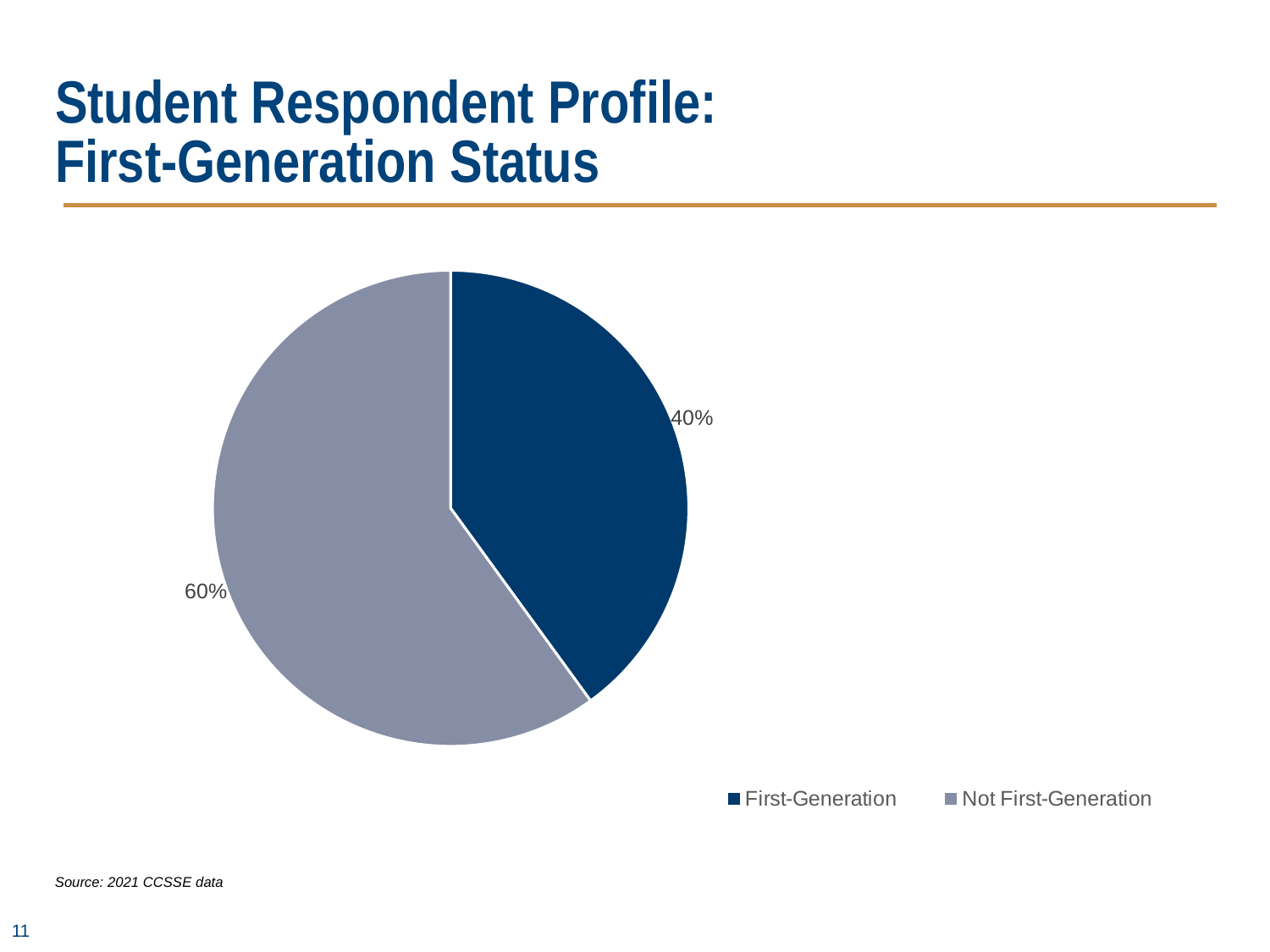
What is the difference in percentage points between Not First-Generation and First-Generation respondents? 20 How many entries does the legend list? 2 How many slices does the pie chart have? 2 Which category has the largest share of the pie? Not First-Generation Which is larger: the share of First-Generation or Not First-Generation respondents? Not First-Generation What percentage of student respondents are First-Generation? 40% What is the source of the data shown in the chart? 2021 CCSSE data What percentage of student respondents are Not First-Generation? 60% What is the title of the slide containing the chart? Student Respondent Profile: First-Generation Status What kind of chart is shown on the slide? Pie chart What share of the pie does the First-Generation slice represent? 40% Which category has the smallest share of the pie? First-Generation